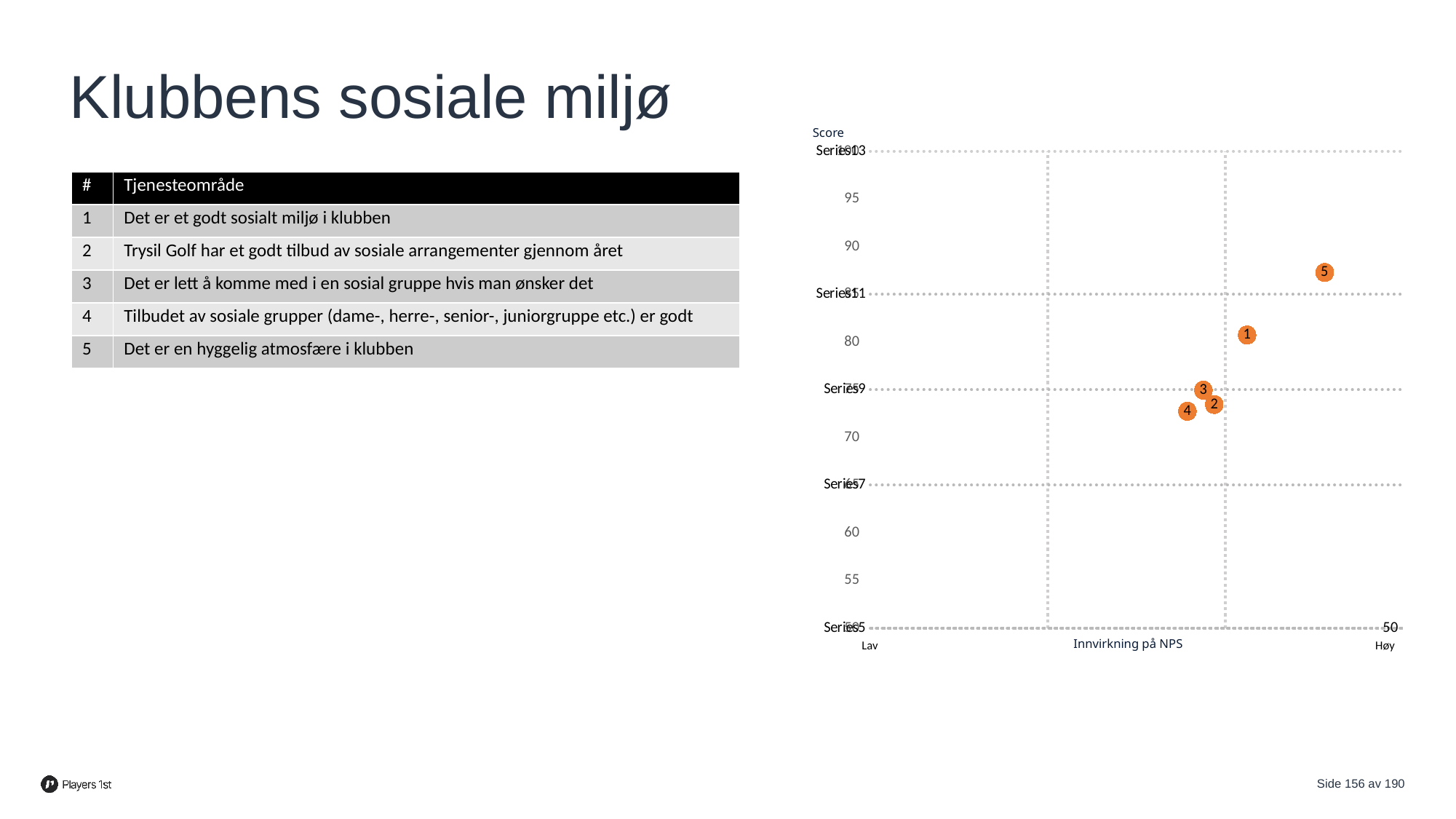
What is the title of the horizontal axis of the chart? Innvirkning på NPS Is the score for point 4 greater or less than 75? less How many data points are plotted in the chart? 5 Is the score for point 5 greater or less than 85? greater Which point lies furthest to the right on the 'Innvirkning på NPS' axis? 5 Which has a higher score, point 5 or point 1? 5 Is the score for point 3 greater or less than 70? greater What kind of chart is shown on the slide? scatter chart Which point has the highest score in the chart? 5 Which has a higher score, point 1 or point 3? 1